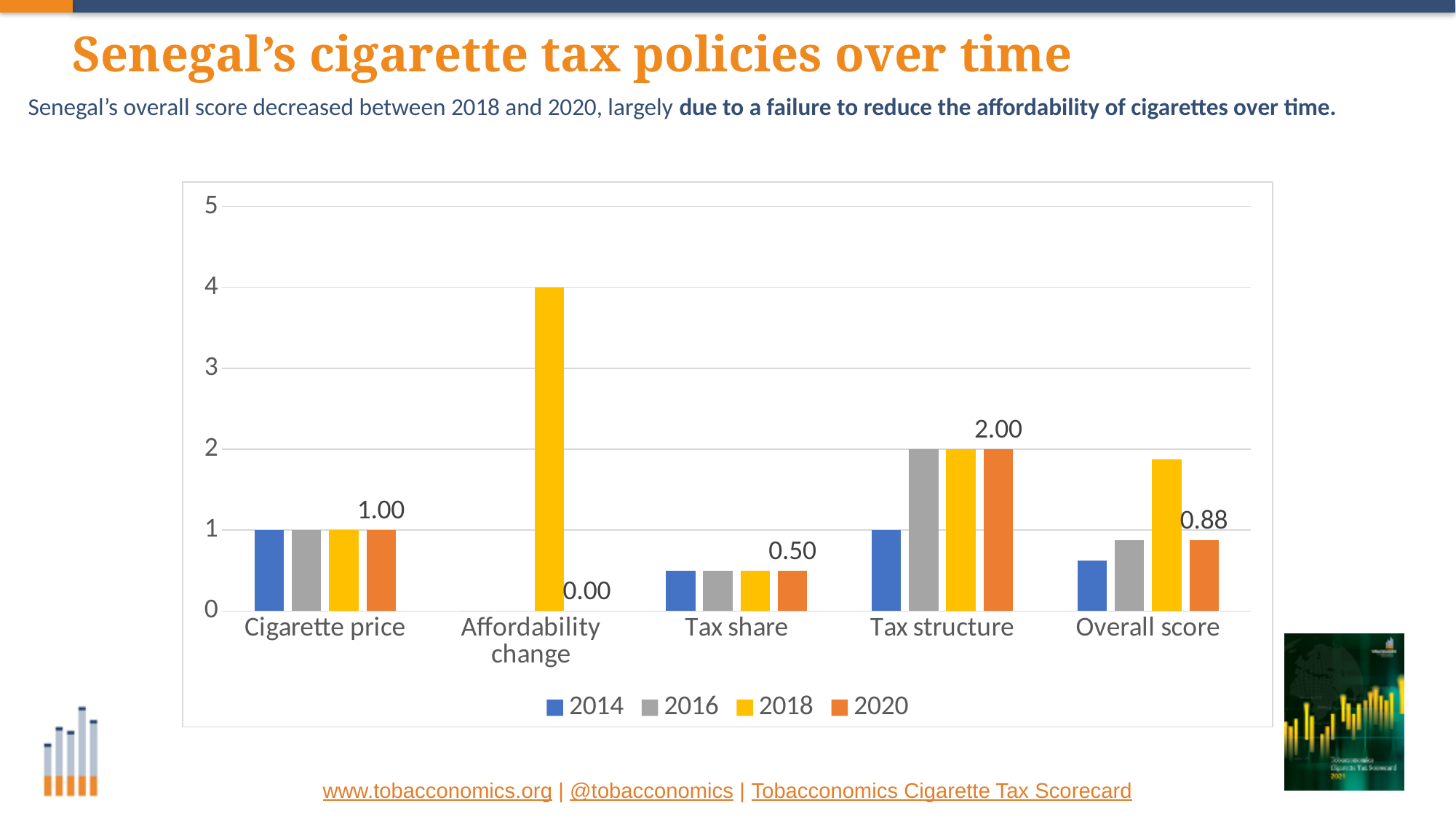
What is the Overall score for 2020? 0.88 Which category has the lowest value for 2020? Affordability change Which category has the highest value for 2020? Tax structure What is the value for Tax structure in 2020? 2.00 What is the value for Cigarette price in 2020? 1.00 What kind of chart is shown on the slide? bar chart What is the value for Tax share in 2020? 0.50 What is the value for Affordability change in 2020? 0.00 What is the difference between the 2020 values for Tax structure and Overall score? 1.12 How many series does the legend list? 4 How many categories are shown on the x axis? 5 Is the 2018 value for Affordability change greater or less than 3? greater